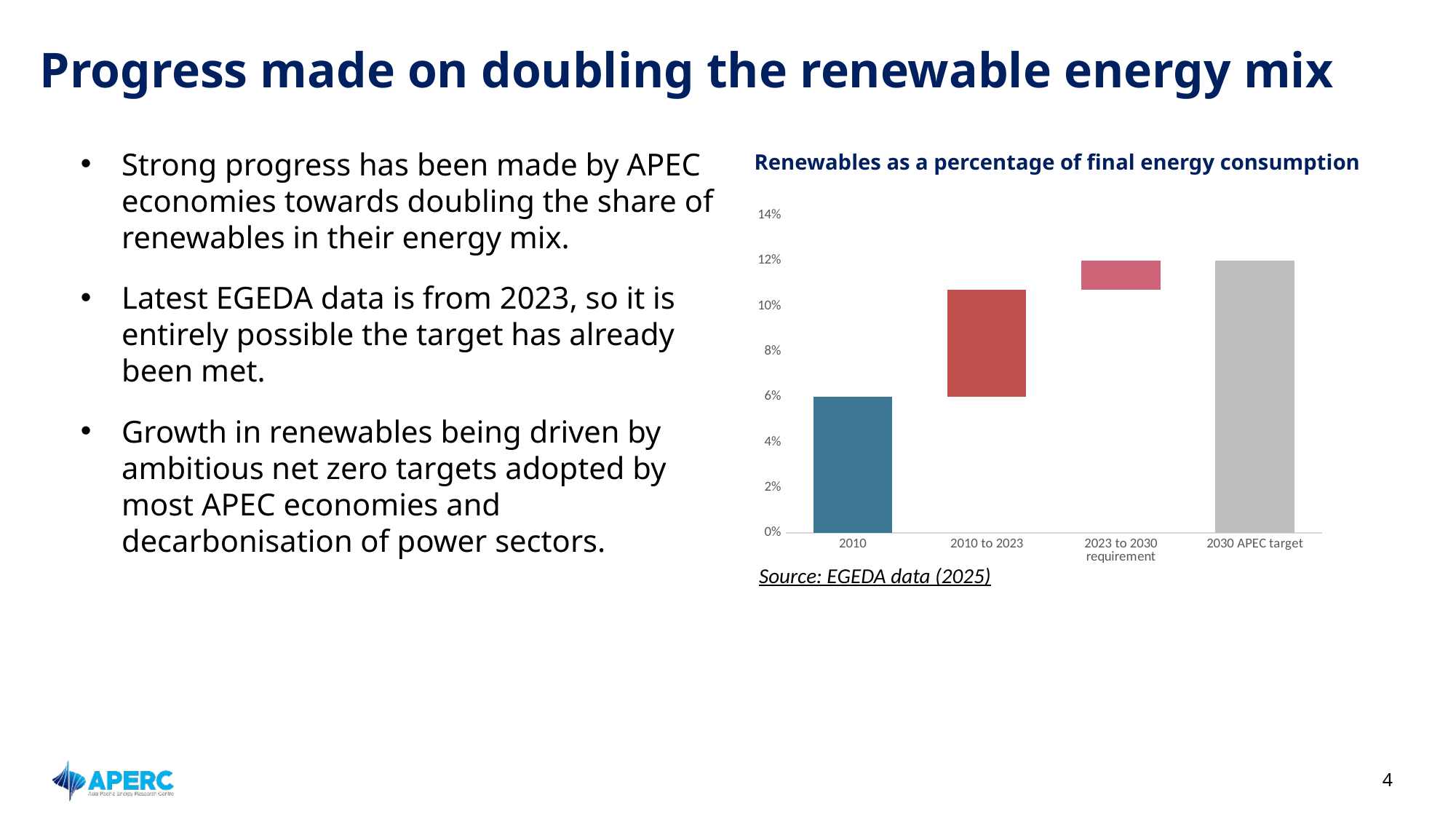
What kind of chart is shown on the slide? Bar chart Do the tops of the bars rise or fall from left to right across the chart? Rise What is the title of the chart? Renewables as a percentage of final energy consumption How many categories are shown on the x axis of the chart? 4 Which is larger, the value for 2030 APEC target or the value for 2010? 2030 APEC target Is the value for 2030 APEC target greater or less than 10%? greater What colour is the 2030 APEC target bar? Grey Is the top of the 2023 to 2030 requirement bar greater or less than 10%? greater Is the value for 2010 greater or less than 8%? less Which category's bar has the lowest top on the chart? 2010